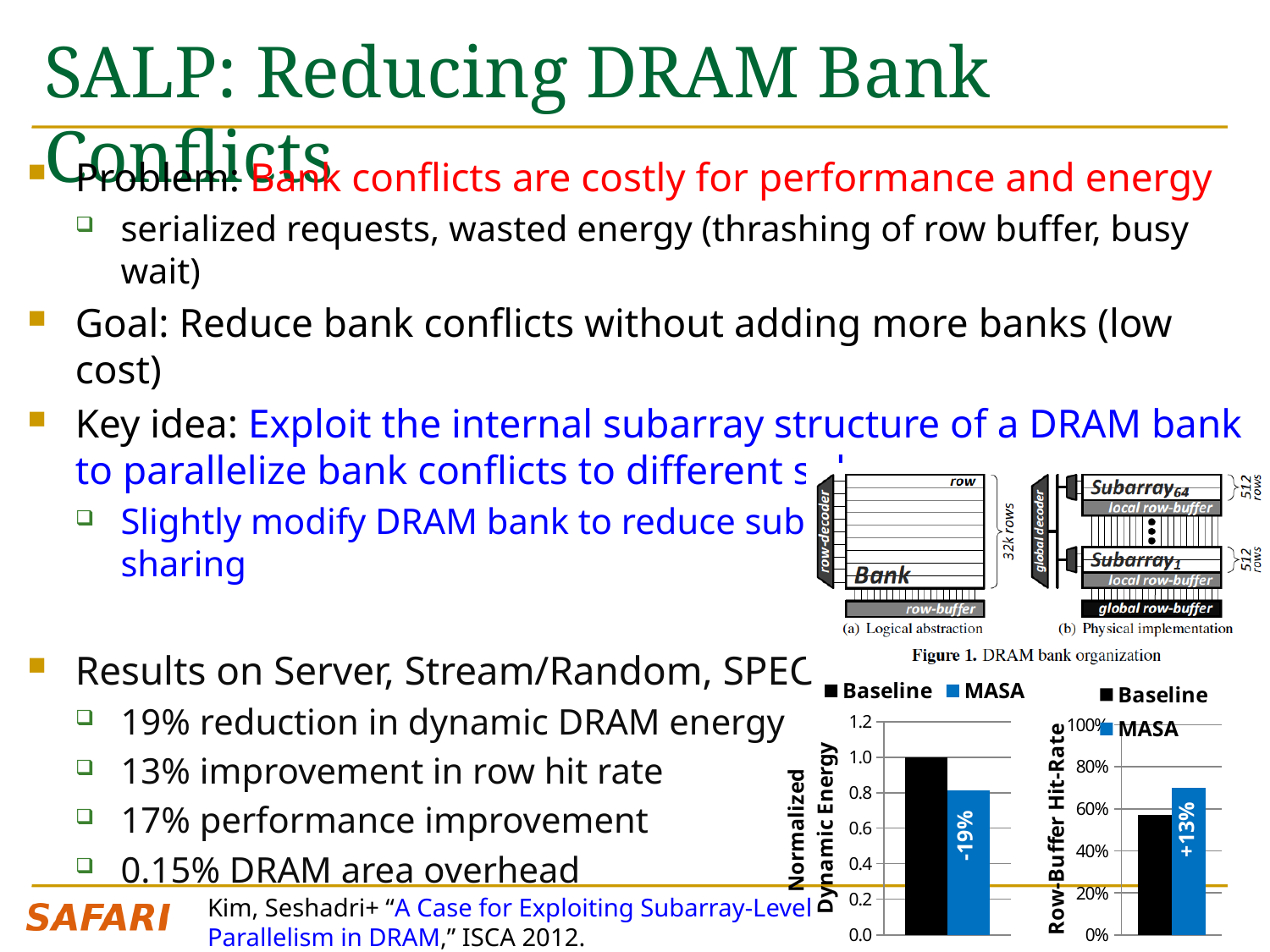
How many series does the legend of the Normalized Dynamic Energy chart list? 2 In the Row-Buffer Hit-Rate chart, is the value for MASA greater or less than 60%? greater In the Row-Buffer Hit-Rate chart, which bar is higher, Baseline or MASA? MASA How many bars are plotted in the Row-Buffer Hit-Rate chart? 2 In the Normalized Dynamic Energy chart, what is the value for Baseline? 1.0 In the Normalized Dynamic Energy chart, what label is printed on the MASA bar? -19% In the Normalized Dynamic Energy chart, is the value for MASA greater or less than 1.0? less In the Row-Buffer Hit-Rate chart, is the value for Baseline greater or less than 40%? greater In the Row-Buffer Hit-Rate chart, what label is printed on the MASA bar? +13% What kind of chart is the Normalized Dynamic Energy chart? bar chart In the Normalized Dynamic Energy chart, which bar is higher, Baseline or MASA? Baseline What are the two legend entries in the Row-Buffer Hit-Rate chart? Baseline and MASA